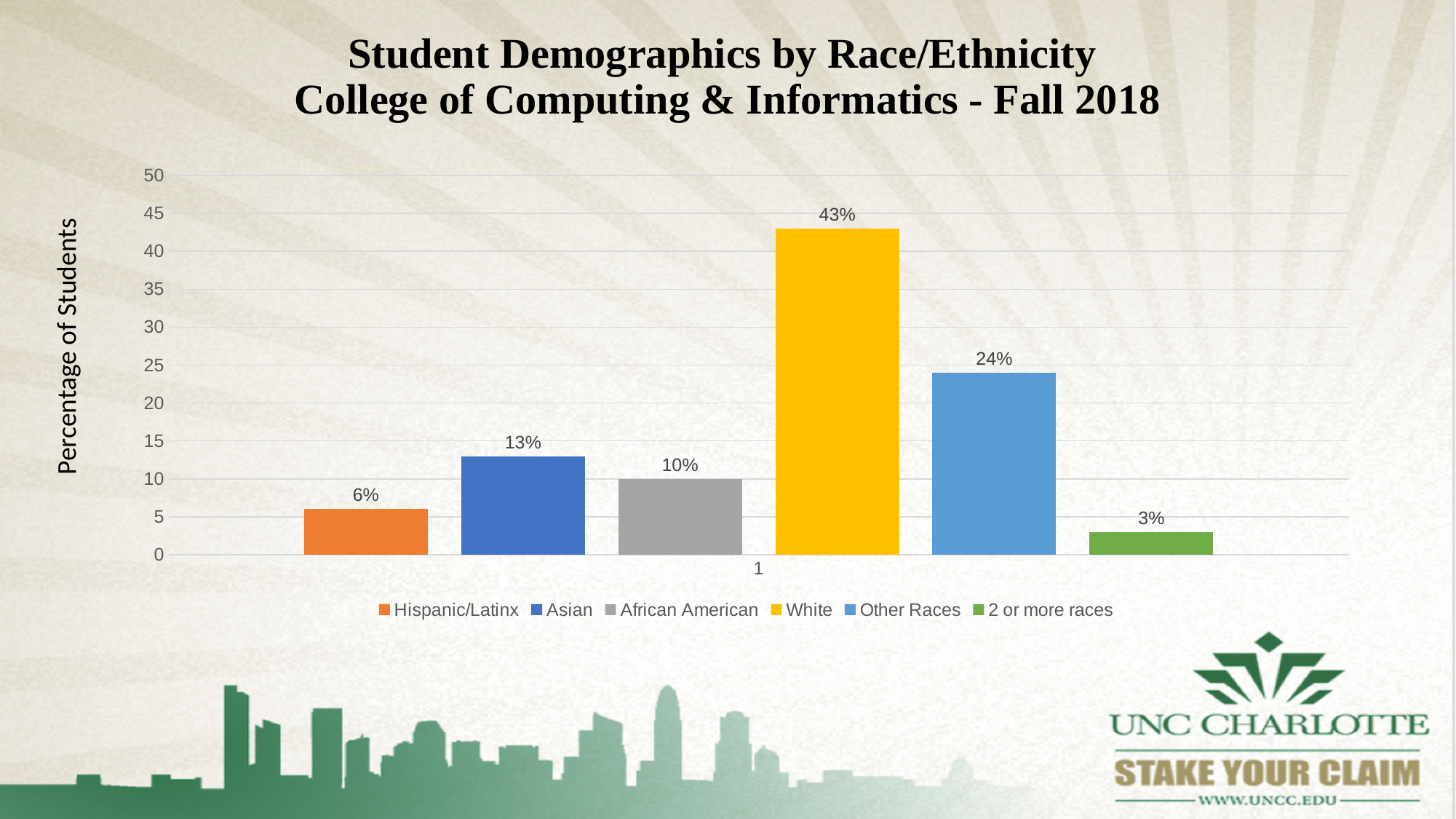
What type of chart is shown on the slide? Bar chart What is the label of the vertical axis? Percentage of Students Which group has a larger share of students, Asian or African American? Asian How many race/ethnicity groups are shown in the chart? 6 Which race/ethnicity group has the highest percentage of students? White What percentage of students are Asian? 13% What is the difference in percentage points between White and Other Races? 19 Is the value for Other Races greater or less than 20? greater What percentage of students are White? 43% Which race/ethnicity group has the lowest percentage of students? 2 or more races What percentage of students are African American? 10% What percentage of students are Hispanic/Latinx? 6%